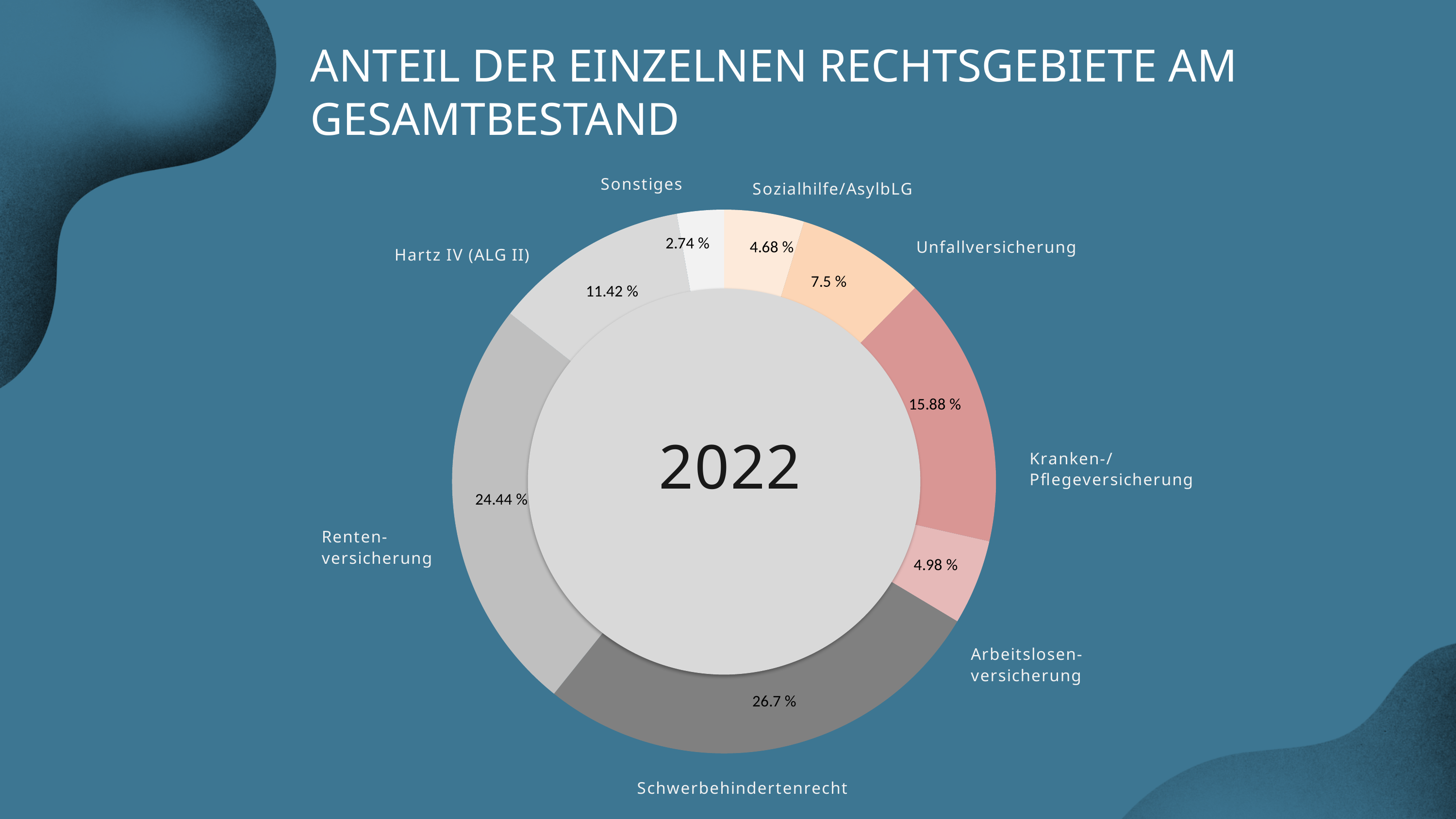
Which category has the smallest share in the chart? Sonstiges What share does Hartz IV (ALG II) have in the chart? 11.42 % What share does Rentenversicherung have in the chart? 24.44 % What is the difference between the shares of Schwerbehindertenrecht and Rentenversicherung? 2.26 % Which has a larger share, Arbeitslosenversicherung or Sozialhilfe/AsylbLG? Arbeitslosenversicherung Which category has the largest share in the chart? Schwerbehindertenrecht What share does Kranken-/Pflegeversicherung have in the chart? 15.88 % How many categories are shown in the chart? 8 What year is shown in the centre of the chart? 2022 What share does Unfallversicherung have in the chart? 7.5 % What kind of chart is shown on the slide? Doughnut chart What share does Schwerbehindertenrecht have in the chart? 26.7 %